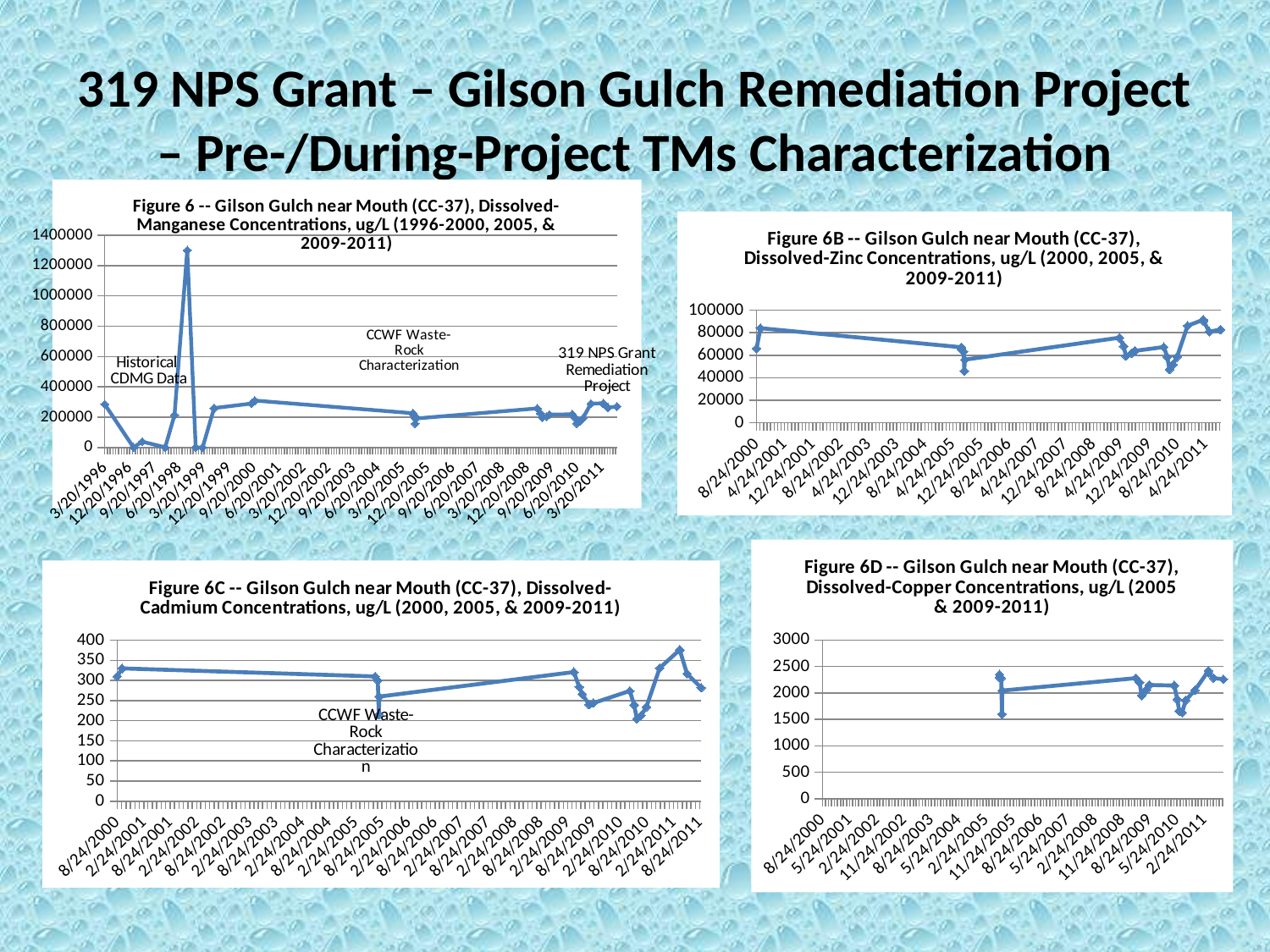
In Figure 6C (Dissolved-Cadmium), is the lowest value plotted around 8/24/2010 greater or less than 250? less What is the highest value shown on the y-axis of Figure 6 (Dissolved-Manganese)? 1400000 In Figure 6D (Dissolved-Copper), are all plotted values greater or less than 3000? less In Figure 6B (Dissolved-Zinc), is the value plotted at 8/24/2000 greater or less than 60000? greater How many charts are shown on the slide? 4 What annotation label appears in the middle of Figure 6 (Dissolved-Manganese) above the 2002-2004 data? CCWF Waste-Rock Characterization What kind of chart is Figure 6 (Dissolved-Manganese Concentrations)? line chart